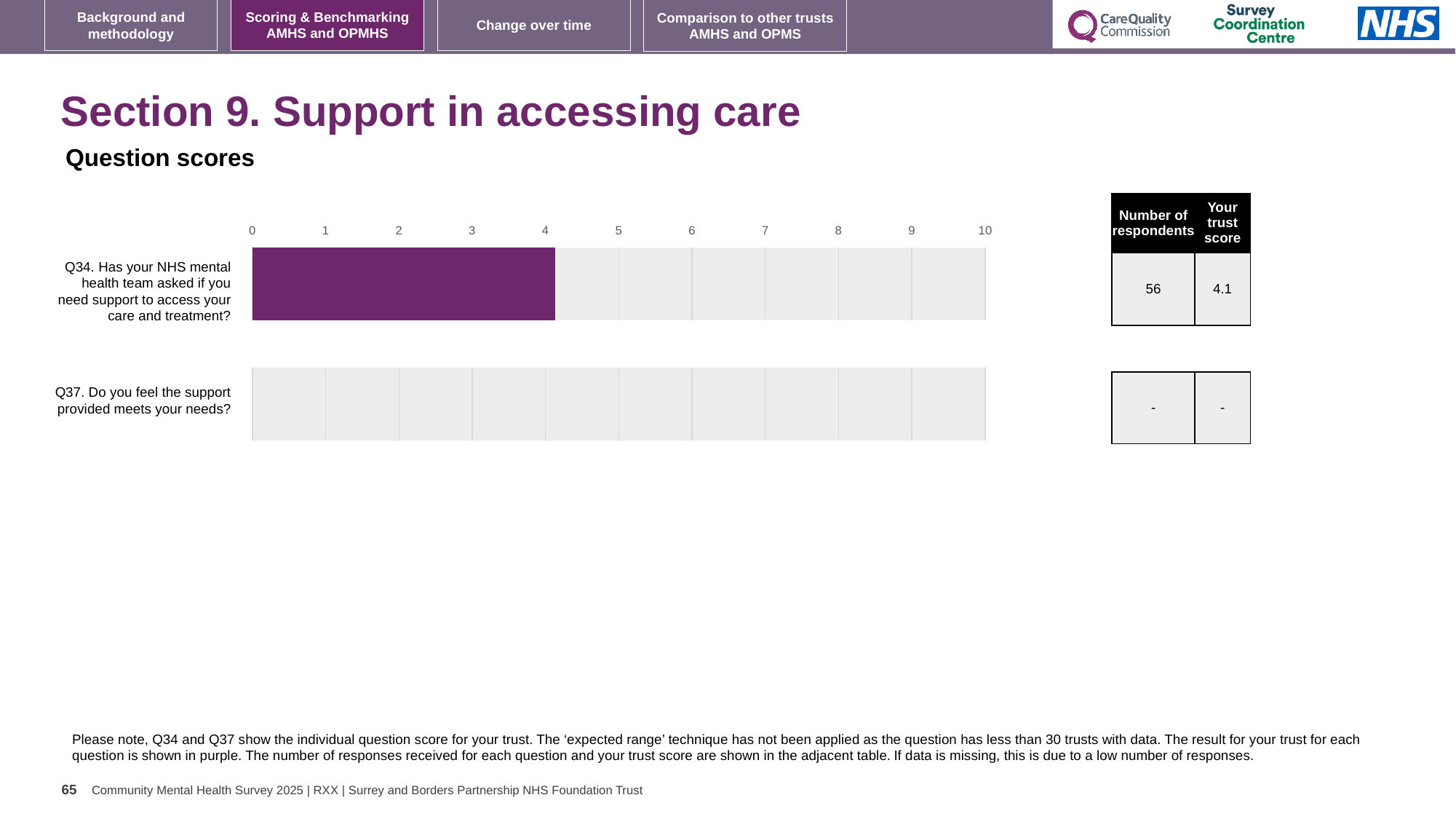
What colour is the bar showing the trust's result for Q34? Purple What is the trust score shown in the table for Q37? - What is the maximum value shown on the chart's axis? 10 Is the trust score for Q34 greater or less than 3? greater How many questions (categories) are listed on the chart? 2 What kind of chart is shown on the slide? Bar chart How many respondents answered Q34? 56 Which question on the chart has no data shown (score displayed as '-')? Q37. Do you feel the support provided meets your needs? What is the trust score for Q34 (Has your NHS mental health team asked if you need support to access your care and treatment?)? 4.1 Is the trust score for Q34 greater or less than 5? less